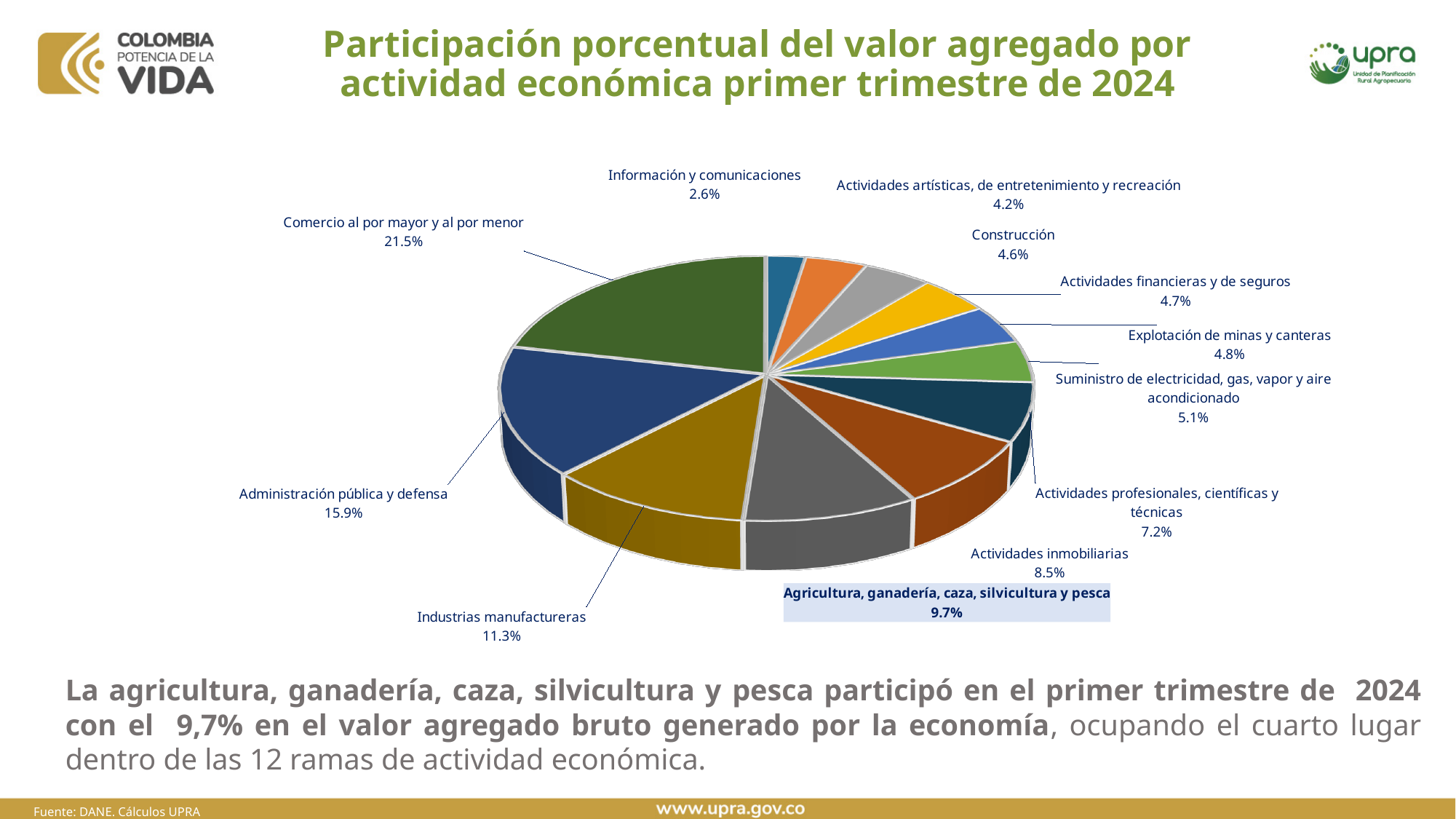
Which activity has the largest share in the pie chart? Comercio al por mayor y al por menor What value is labelled for Industrias manufactureras? 11.3% What is the difference in percentage points between Comercio al por mayor y al por menor and Administración pública y defensa? 5.6 What is the title of the chart on the slide? Participación porcentual del valor agregado por actividad económica primer trimestre de 2024 What share is shown for Suministro de electricidad, gas, vapor y aire acondicionado? 5.1% What is the share shown for Agricultura, ganadería, caza, silvicultura y pesca? 9.7% Which has a larger share, Actividades inmobiliarias or Actividades profesionales, científicas y técnicas? Actividades inmobiliarias Which activity has the smallest share in the pie chart? Información y comunicaciones What is the difference in percentage points between Industrias manufactureras and Agricultura, ganadería, caza, silvicultura y pesca? 1.6 What type of chart is shown on the slide? Pie chart How many activity categories are shown in the pie chart? 12 What percentage share does Comercio al por mayor y al por menor have in the pie chart? 21.5%